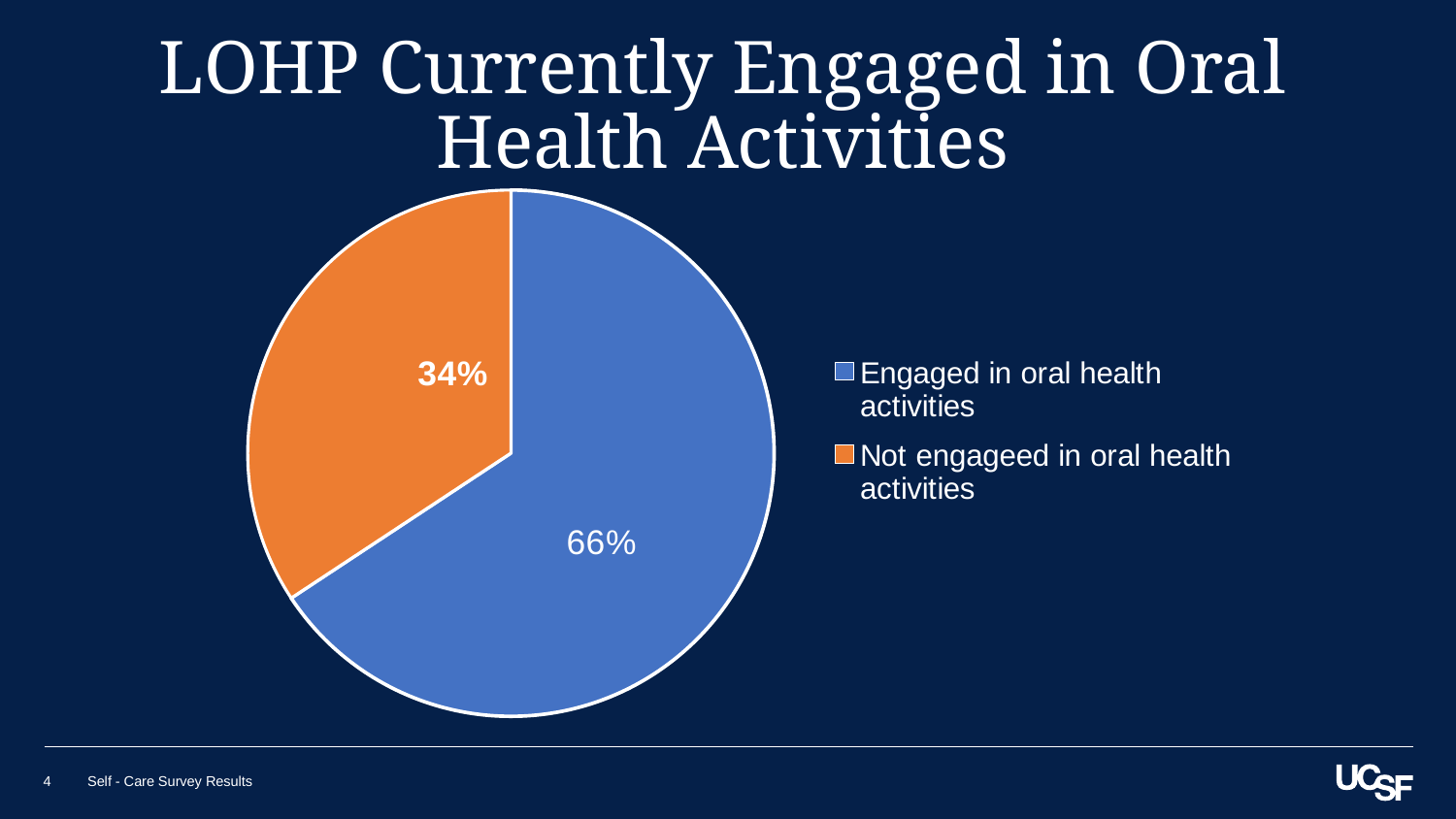
What colour is the slice for 'Not engageed in oral health activities'? orange What is the title of the slide containing the pie chart? LOHP Currently Engaged in Oral Health Activities Which category has the largest share of the pie? Engaged in oral health activities What percentage of LOHP are not engaged in oral health activities? 34% What is the difference in percentage points between the engaged and not engaged slices? 32 Which is larger: the share engaged in oral health activities or the share not engaged? Engaged in oral health activities How many slices does the pie chart have? 2 How many entries does the legend list? 2 What kind of chart is shown on the slide? pie chart Which category has the smallest share of the pie? Not engageed in oral health activities What share of the pie does the 'Engaged in oral health activities' slice represent? 66% What percentage of LOHP are engaged in oral health activities? 66%